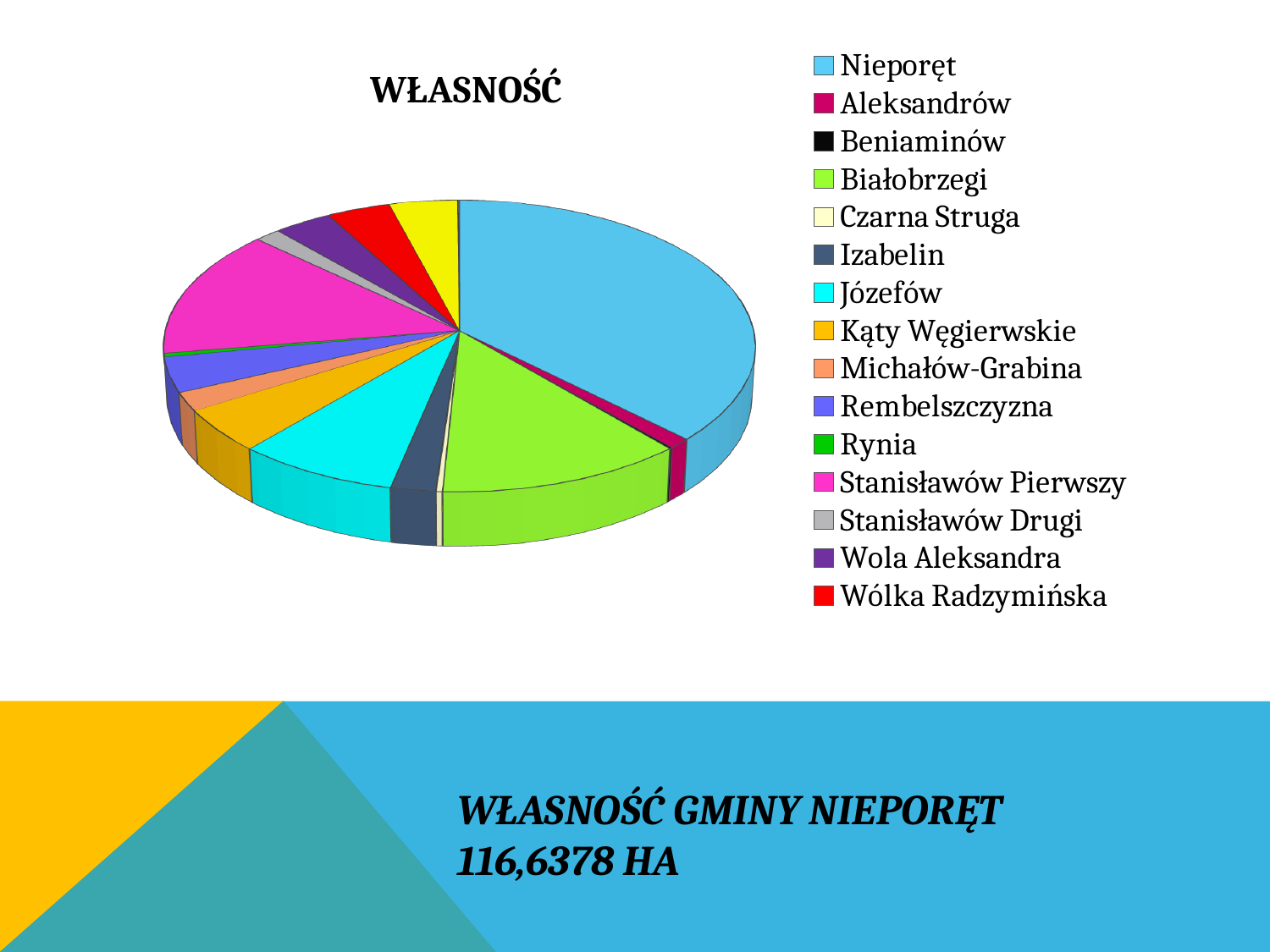
Which slice is larger, Nieporęt or Białobrzegi? Nieporęt Which slice is larger, Józefów or Czarna Struga? Józefów Which slice is larger, Stanisławów Pierwszy or Stanisławów Drugi? Stanisławów Pierwszy How many categories does the legend of the pie chart list? 15 What kind of chart is shown on the slide? pie chart What colour is the slice for Wólka Radzymińska? red Which category has the largest slice of the pie? Nieporęt What is the title of the chart? WŁASNOŚĆ